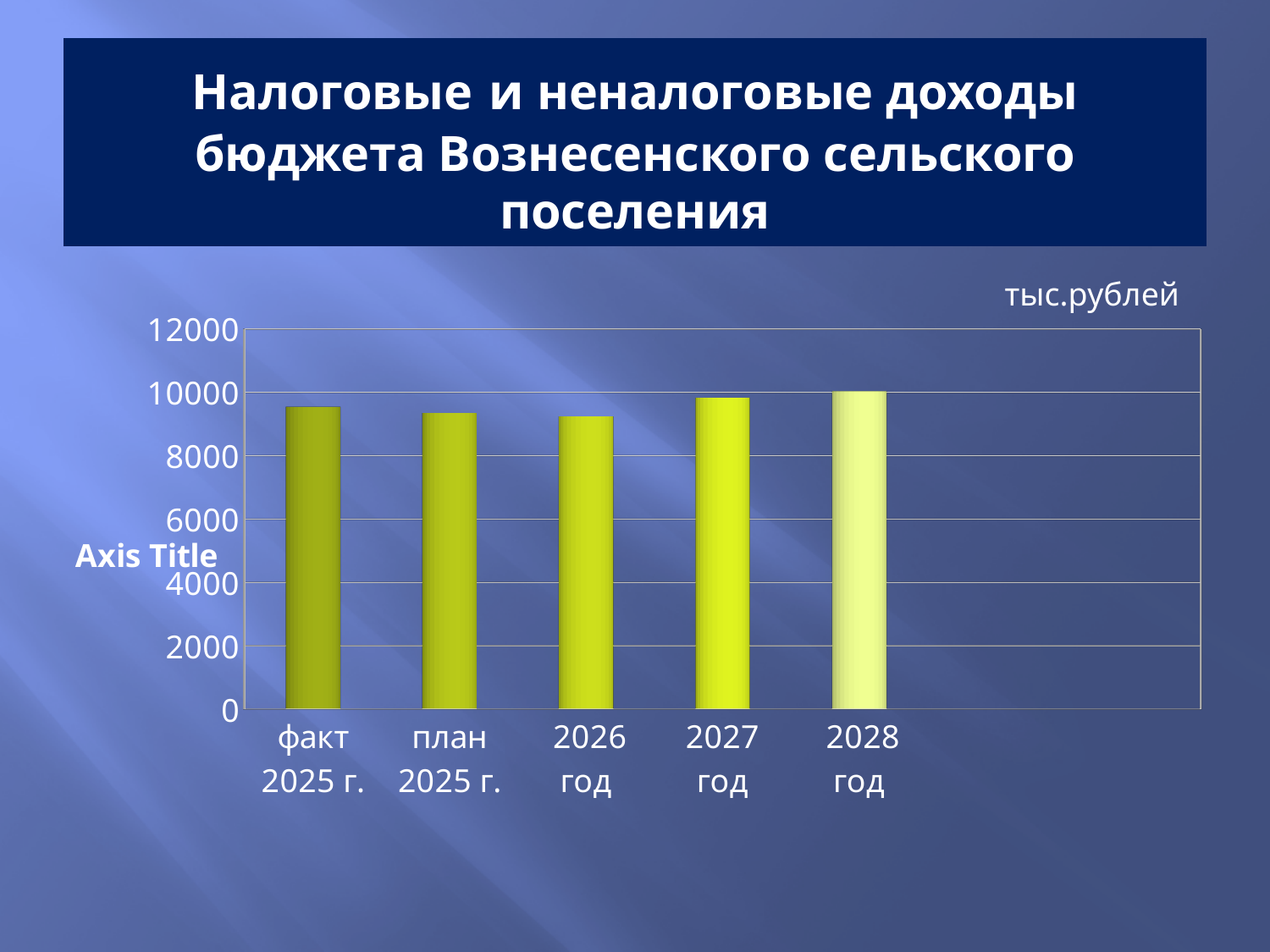
What is the title of the slide above the chart? Налоговые и неналоговые доходы бюджета Вознесенского сельского поселения Which is larger, the value for факт 2025 г. or the value for 2026 год? факт 2025 г. What is the highest value shown on the vertical axis? 12000 Is the value for план 2025 г. greater or less than 6000? greater Is the value for факт 2025 г. greater or less than 8000? greater What unit label is shown above the chart on the right? тыс.рублей Is the value for 2028 год greater or less than 12000? less How many bars (categories) are shown in the chart? 5 What kind of chart is shown on the slide? bar chart Which is larger, the value for 2028 год or the value for 2026 год? 2028 год Which is larger, the value for 2027 год or the value for план 2025 г.? 2027 год